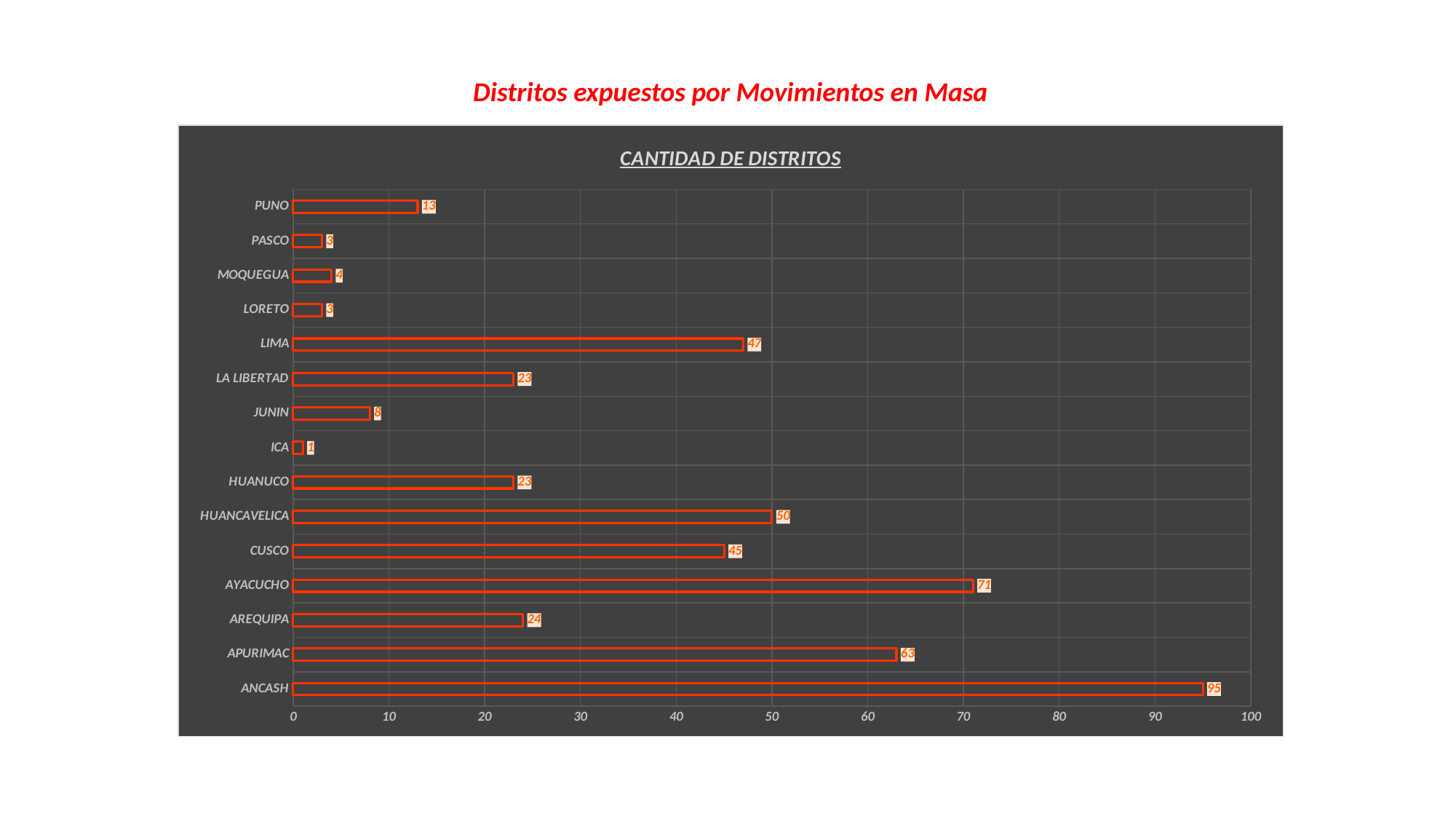
How many categories are shown on the chart? 15 What is the difference between the values for AYACUCHO and APURIMAC? 8 What kind of chart is shown on the slide? bar chart What is the value for ANCASH? 95 What is the value for LIMA? 47 What is the difference between the values for PUNO and JUNIN? 5 What is the title of the chart? CANTIDAD DE DISTRITOS Is the value for AYACUCHO greater or less than 60? greater Which is larger, the value for CUSCO or the value for LA LIBERTAD? CUSCO Which category has the lowest value? ICA Which category has the highest value? ANCASH What is the value for HUANCAVELICA? 50